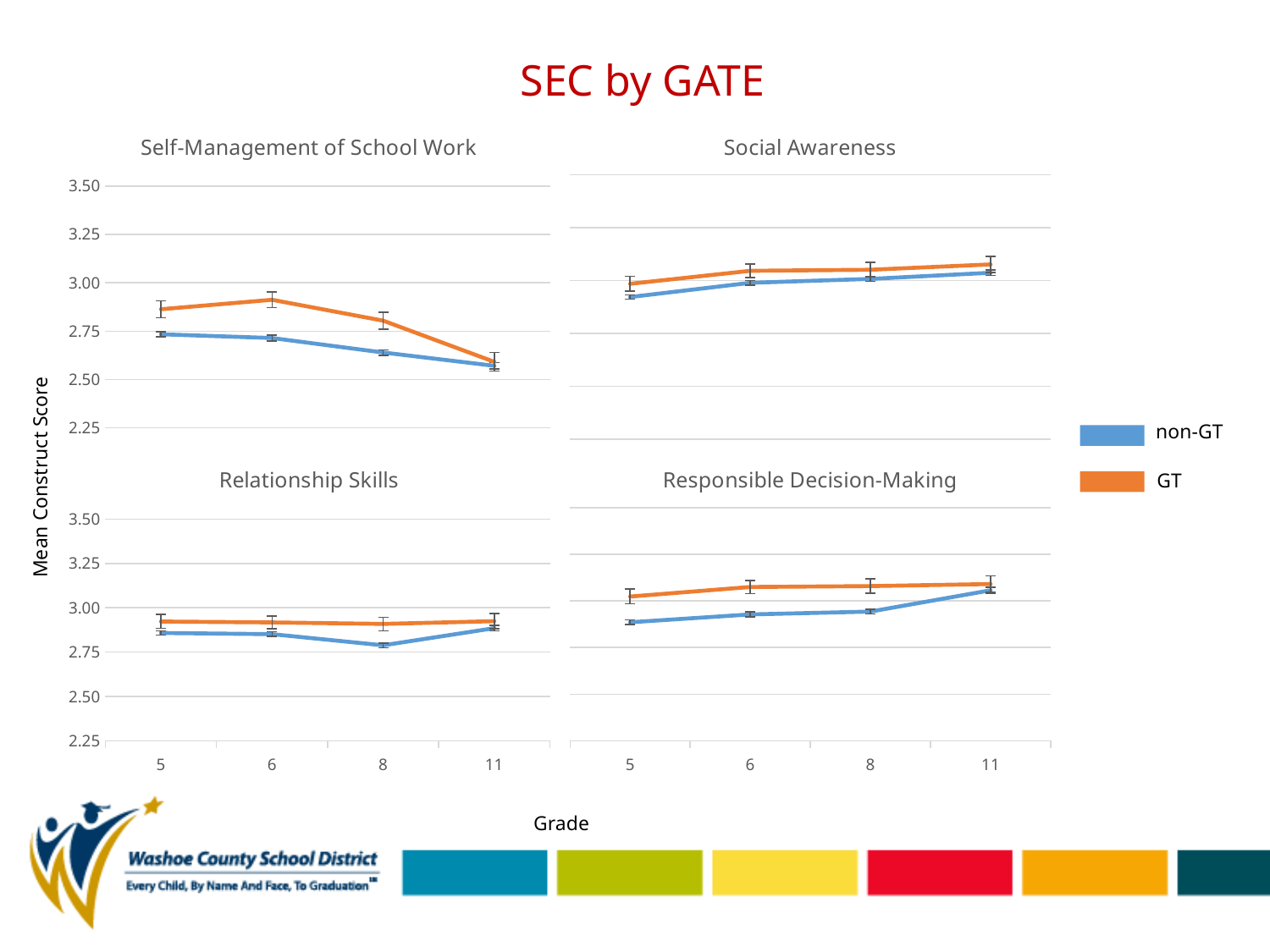
In the Relationship Skills chart, at grade 8, which series has the larger value, GT or non-GT? GT What kind of chart is used in the Self-Management of School Work panel? line chart In the Responsible Decision-Making chart, is the non-GT value at grade 5 greater or less than 3.00? less In the Self-Management of School Work chart, do the non-GT values rise or fall from grade 5 to grade 11? fall How many series does the legend list? 2 In the Social Awareness chart, at which grade is the non-GT value highest? 11 In the Social Awareness chart, do the GT values rise or fall from grade 5 to grade 11? rise In the Self-Management of School Work chart, is the GT value at grade 5 greater or less than 2.75? greater In the Self-Management of School Work chart, is the non-GT value at grade 11 greater or less than 2.75? less In the Social Awareness chart, how many grade levels are plotted along the x axis? 4 In the Relationship Skills chart, at which grade is the non-GT value lowest? 8 What is the title of the vertical axis shared by the four charts? Mean Construct Score